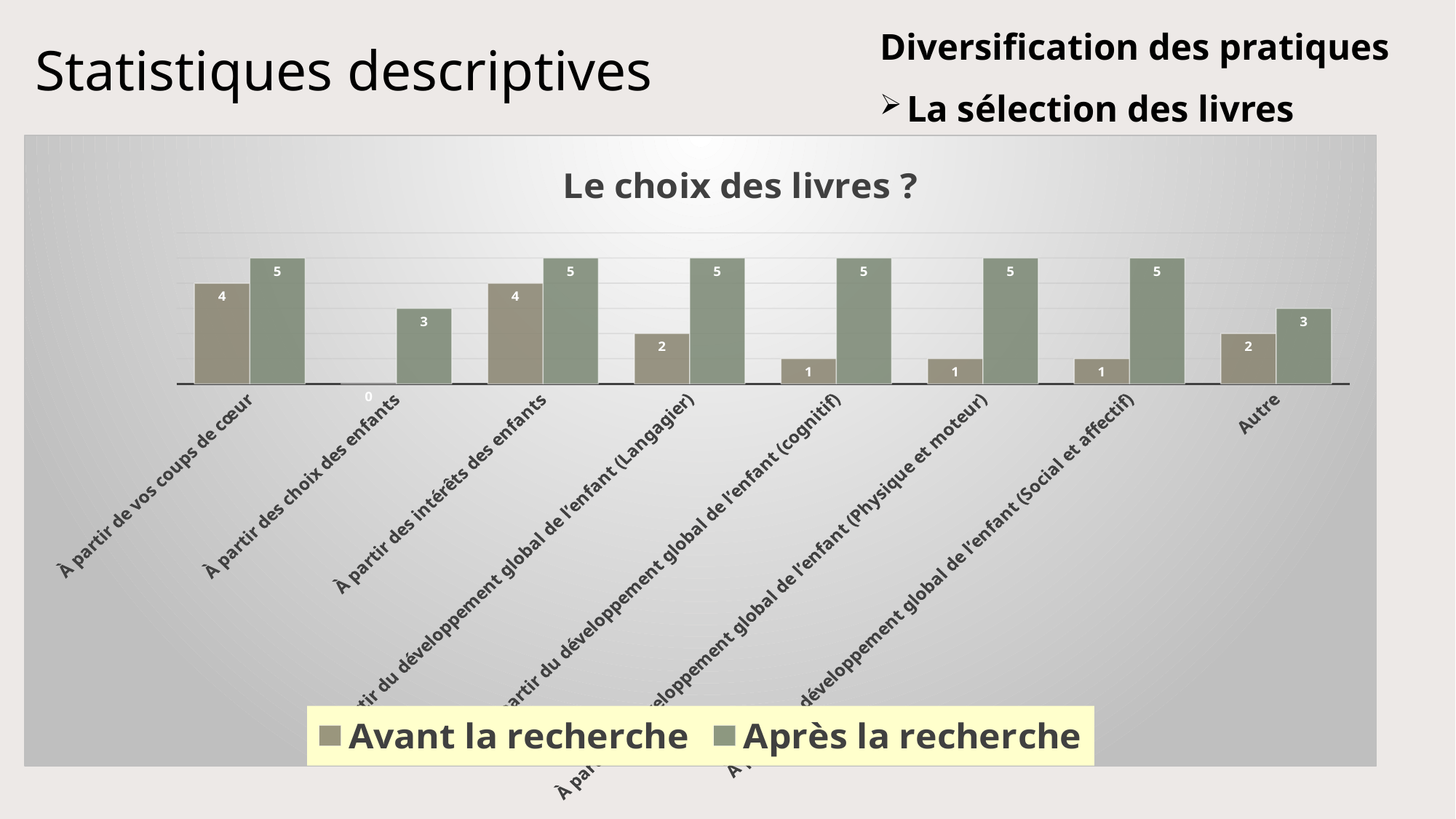
Which category has the lowest "Avant la recherche" value? À partir des choix des enfants What is the value for "Après la recherche" for "À partir des choix des enfants"? 3 What is the title of the chart? Le choix des livres ? How many series does the legend list? 2 What is the difference between the "Après la recherche" and "Avant la recherche" values for "À partir du développement global de l'enfant (Langagier)"? 3 What is the value for "Avant la recherche" for "À partir du développement global de l'enfant (Social et affectif)"? 1 What is the value for "Avant la recherche" for "À partir de vos coups de cœur"? 4 What is the value for "Après la recherche" for "Autre"? 3 What kind of chart is shown on the slide? Bar chart What is the value for "Avant la recherche" for "À partir du développement global de l'enfant (cognitif)"? 1 How many categories are shown on the x axis? 8 For "À partir des intérêts des enfants", which is larger: "Avant la recherche" or "Après la recherche"? Après la recherche